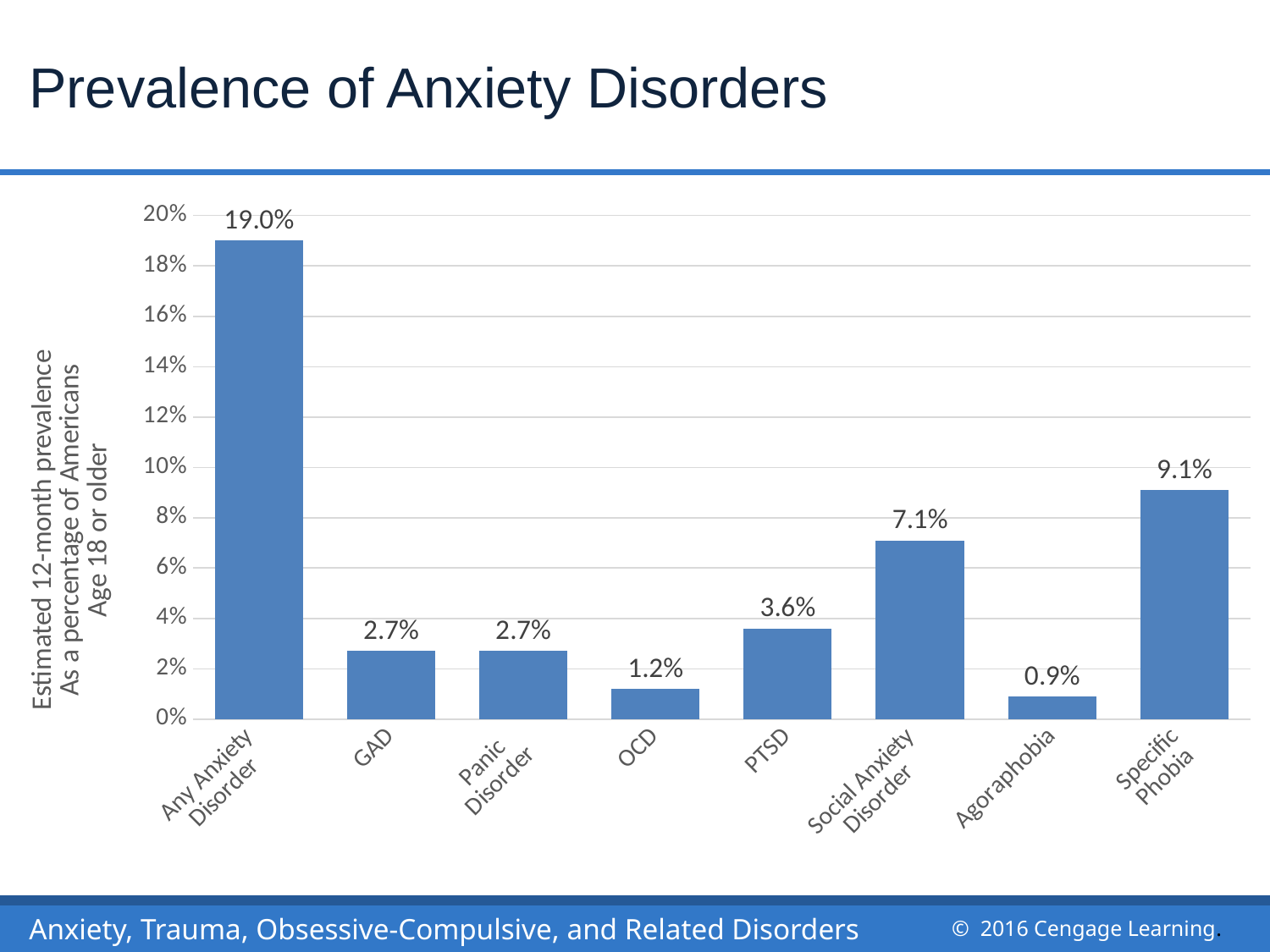
Which category has the lowest value? Agoraphobia Which is larger, the value for OCD or the value for GAD? GAD What is the prevalence value shown for Agoraphobia? 0.9% What is the title of the slide? Prevalence of Anxiety Disorders What is the prevalence value shown for PTSD? 3.6% What is the difference between the values for Social Anxiety Disorder and PTSD? 3.5% What kind of chart is shown on the slide? Bar chart Is the value for Social Anxiety Disorder greater or less than 6%? greater What is the prevalence value shown for Specific Phobia? 9.1% Which category has the highest value? Any Anxiety Disorder What is the difference between the values for Any Anxiety Disorder and Specific Phobia? 9.9% How many categories are shown on the x axis? 8